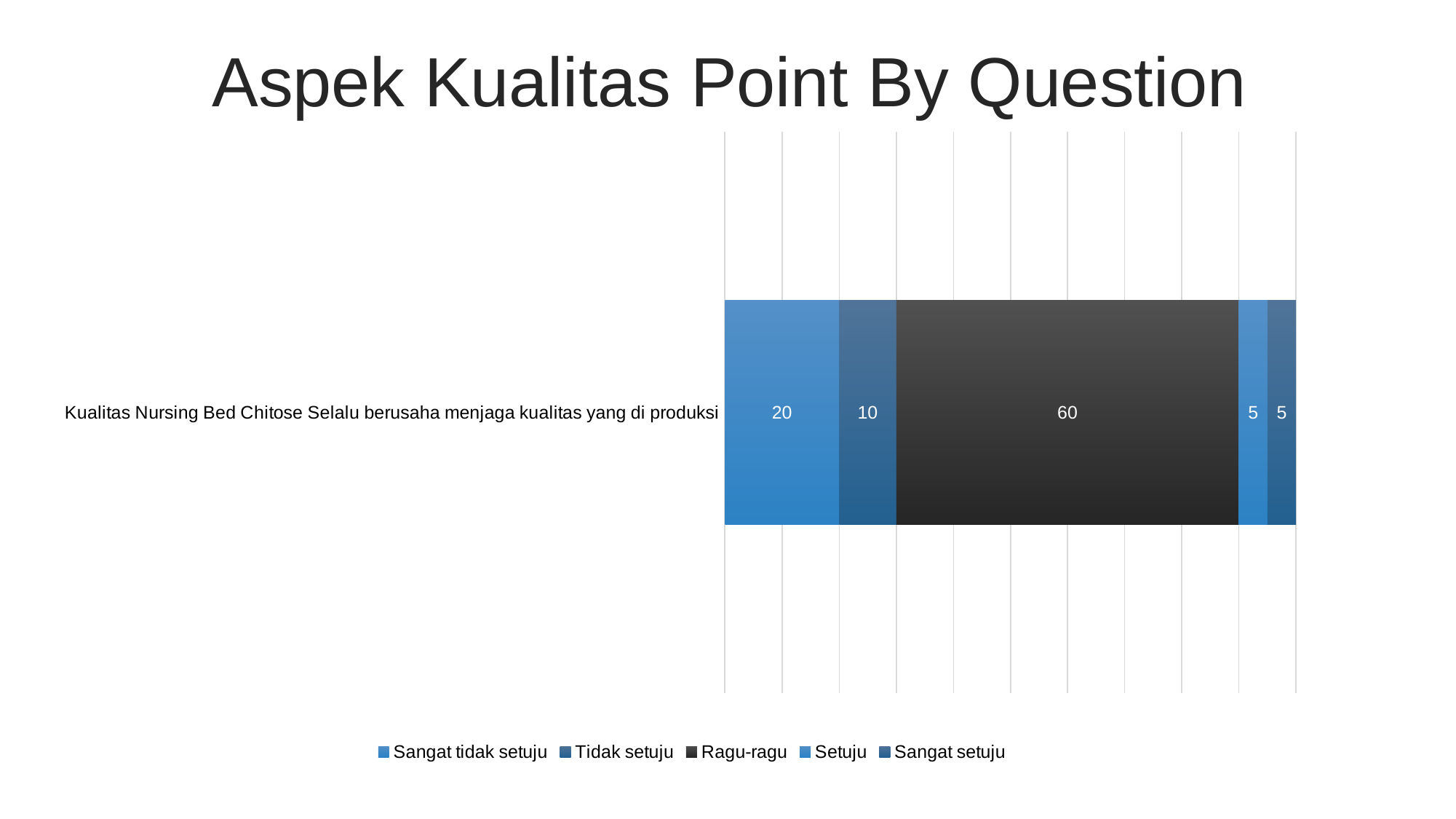
How many categories are plotted on the chart? 1 What kind of chart is shown on the slide? Stacked bar chart Which is larger, the value for Sangat tidak setuju or the value for Tidak setuju? Sangat tidak setuju What is the difference between the Ragu-ragu value and the Sangat tidak setuju value? 40 Which series has the largest value in the bar? Ragu-ragu What is the value for Tidak setuju? 10 What is the value for Setuju? 5 What is the total of all segments in the stacked bar? 100 What is the value for Sangat tidak setuju? 20 How many series does the legend list? 5 What is the title of the slide? Aspek Kualitas Point By Question What is the value for Ragu-ragu in the stacked bar? 60